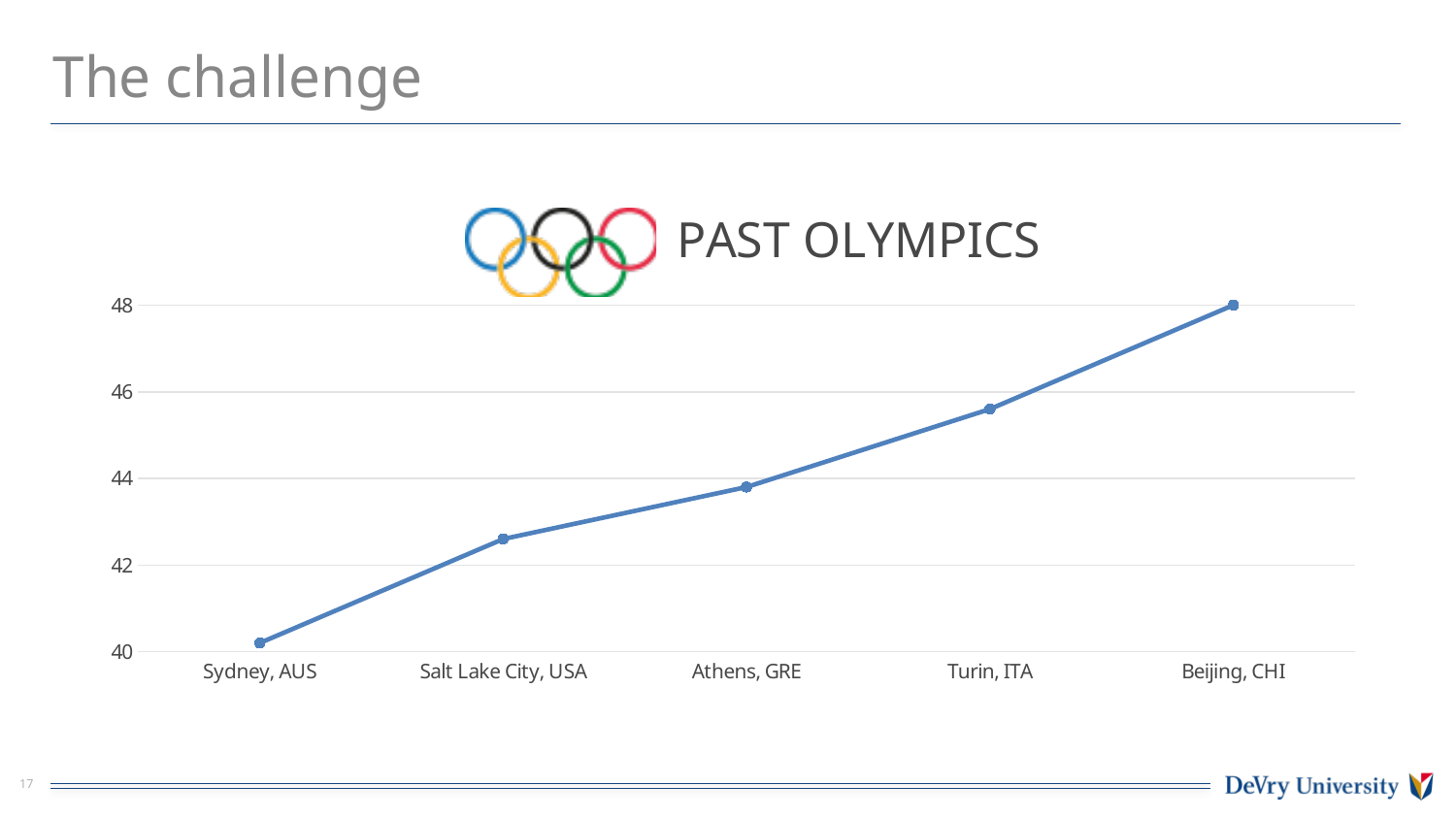
Which host city has the highest value on the chart? Beijing, CHI Is the value for Salt Lake City, USA greater or less than 42? greater What is the title of the chart? PAST OLYMPICS Do the values rise or fall from Sydney, AUS to Beijing, CHI along the x axis? rise Which is larger, the value for Athens, GRE or the value for Turin, ITA? Turin, ITA What kind of chart is shown on the slide? line chart Is the value for Sydney, AUS greater or less than 42? less How many host cities are plotted on the chart? 5 Is the value for Athens, GRE greater or less than 44? less Which host city is plotted first on the x axis? Sydney, AUS Which host city has the lowest value on the chart? Sydney, AUS